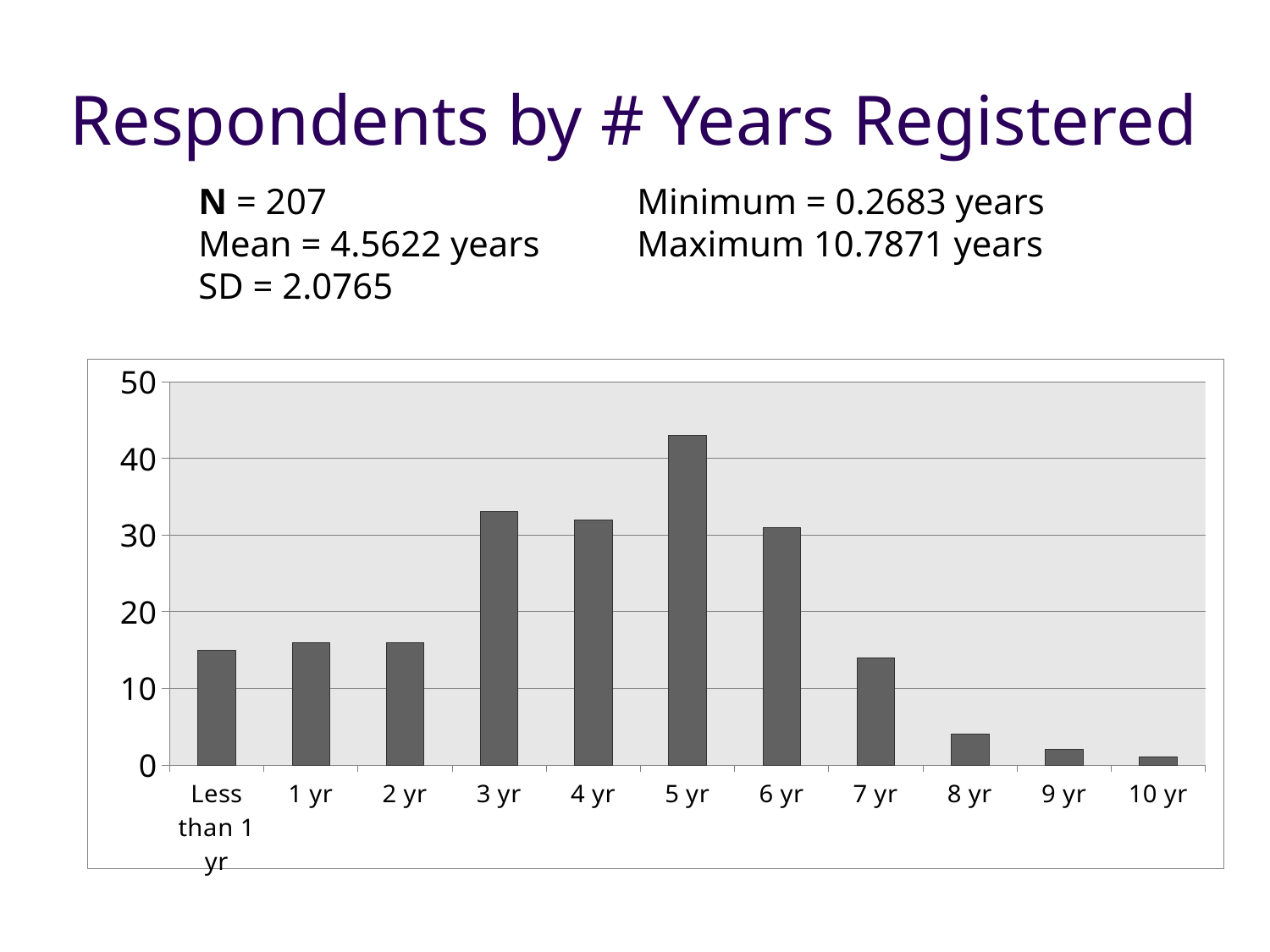
Which category has the highest number of respondents? 5 yr Is the value for Less than 1 yr greater or less than 20? less Is the value for 3 yr greater or less than 30? greater Is the value for 5 yr greater or less than 40? greater Which category has the lowest number of respondents? 10 yr What is the title of the slide containing the chart? Respondents by # Years Registered Do the values rise or fall from 5 yr to 10 yr? fall Which has more respondents, 7 yr or 8 yr? 7 yr What kind of chart is shown on the slide? bar chart How many categories are shown on the x axis of the chart? 11 Which has more respondents, 5 yr or 3 yr? 5 yr